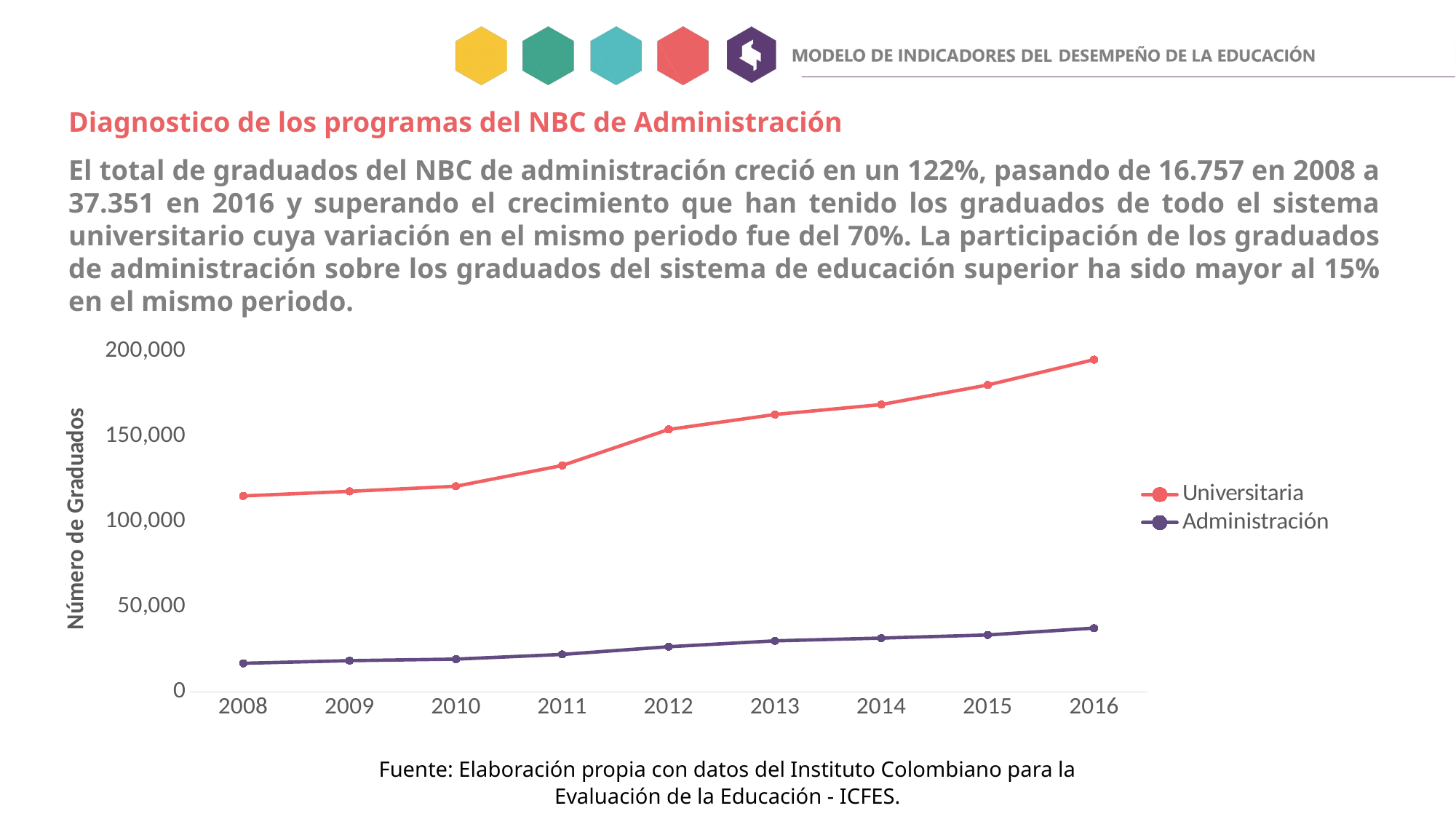
Is the value for Universitaria in 2016 greater or less than 200,000? less Which series are listed in the legend? Universitaria and Administración What is the title of the vertical axis? Número de Graduados Do the values for Administración rise or fall from 2008 to 2016? rise What kind of chart is shown on the slide? line chart In which year does the Universitaria series reach its highest value? 2016 Is the value for Universitaria in 2013 greater or less than 150,000? greater In which year does the Administración series have its lowest value? 2008 Is the value for Administración in 2016 greater or less than 50,000? less How many series does the legend list? 2 How many years are plotted along the x axis? 9